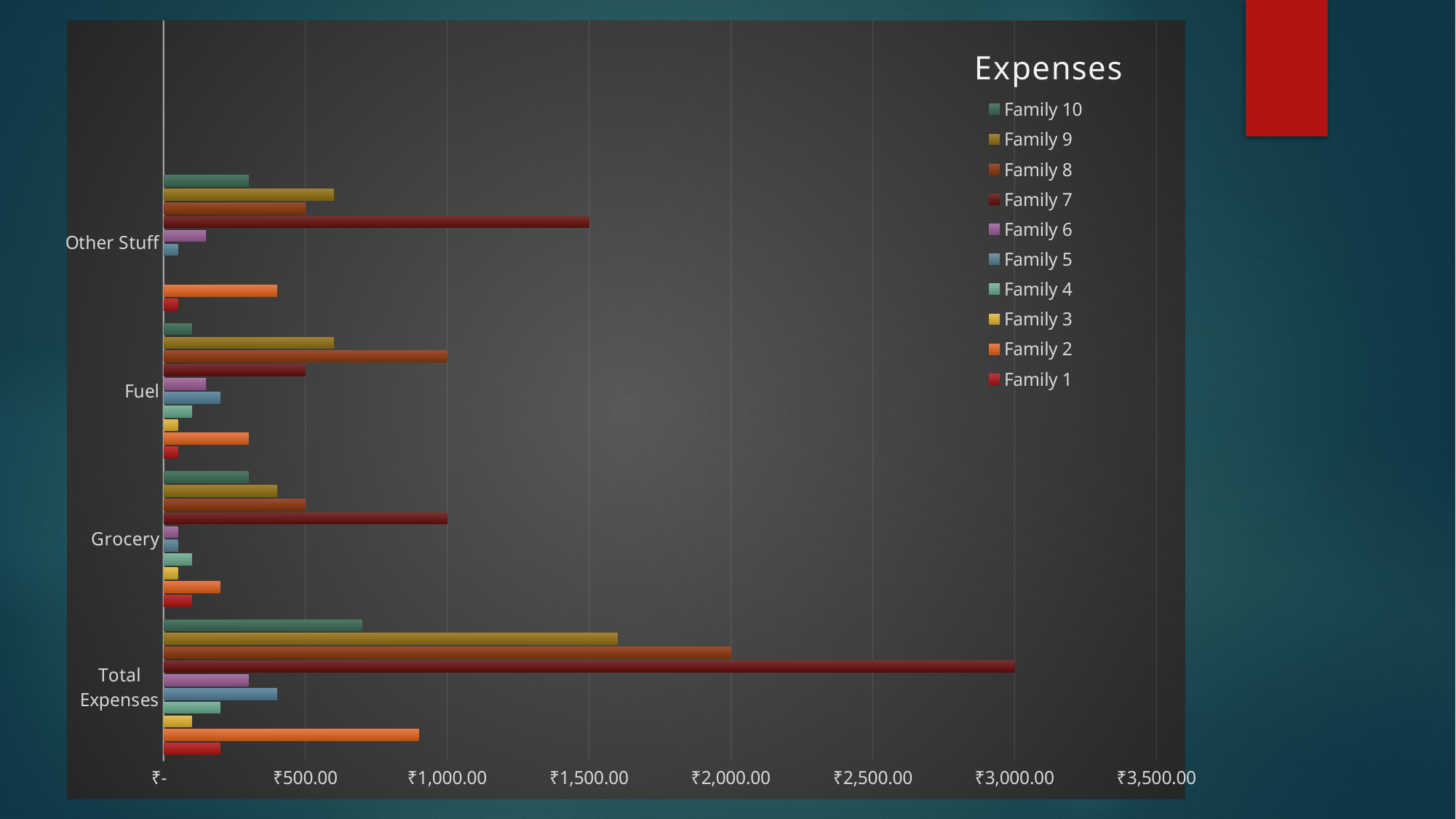
How many series does the legend list? 10 What is the Total Expenses value for Family 7? ₹3,000.00 Which family has the lowest Total Expenses? Family 3 What kind of chart is shown on the slide? bar chart How many categories are shown on the vertical axis? 4 Which family has the highest Total Expenses? Family 7 For Other Stuff, which is larger: Family 9 or Family 10? Family 9 What is the Total Expenses value for Family 8? ₹2,000.00 What is the Other Stuff value for Family 7? ₹1,500.00 What is the title of the chart? Expenses Is the Total Expenses value for Family 9 greater or less than ₹1,500.00? greater What is the difference between the Total Expenses of Family 7 and Family 8? ₹1,000.00